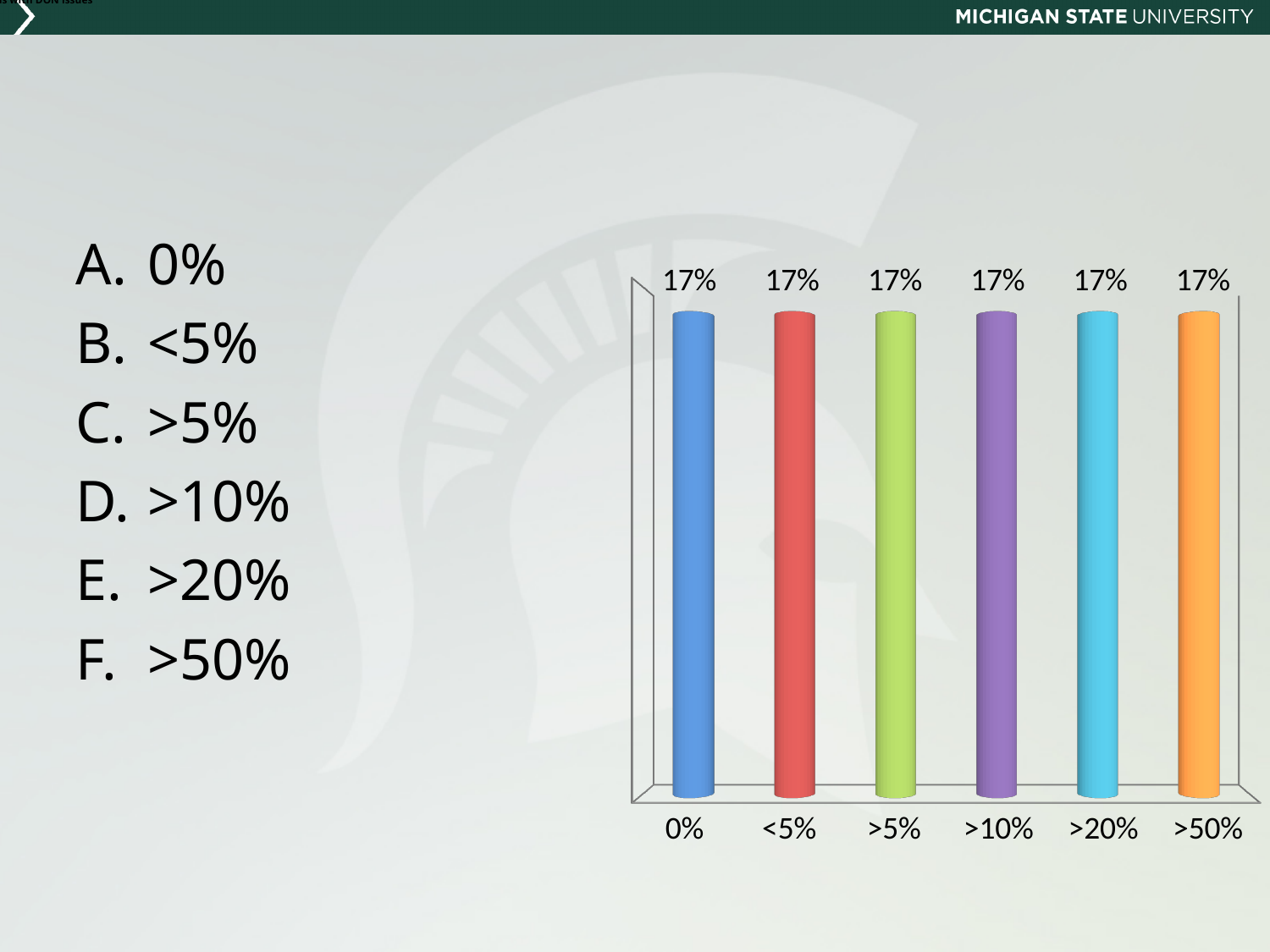
What is the label of the first category on the x axis? 0% Do the values rise, fall, or stay flat across the categories from 0% to >50%? stay flat What is the value shown for the 0% category? 17% What is the difference between the values for >5% and >20%? 0% How many categories are shown on the x axis of the chart? 6 What kind of chart is shown on the slide? bar chart What is the value shown for the >50% category? 17% What is the value shown for the >10% category? 17% Is the value for 0% larger than, smaller than, or equal to the value for >50%? equal What is the value shown for the <5% category? 17% What colour is the bar for the >10% category? purple What is the value shown for the >20% category? 17%